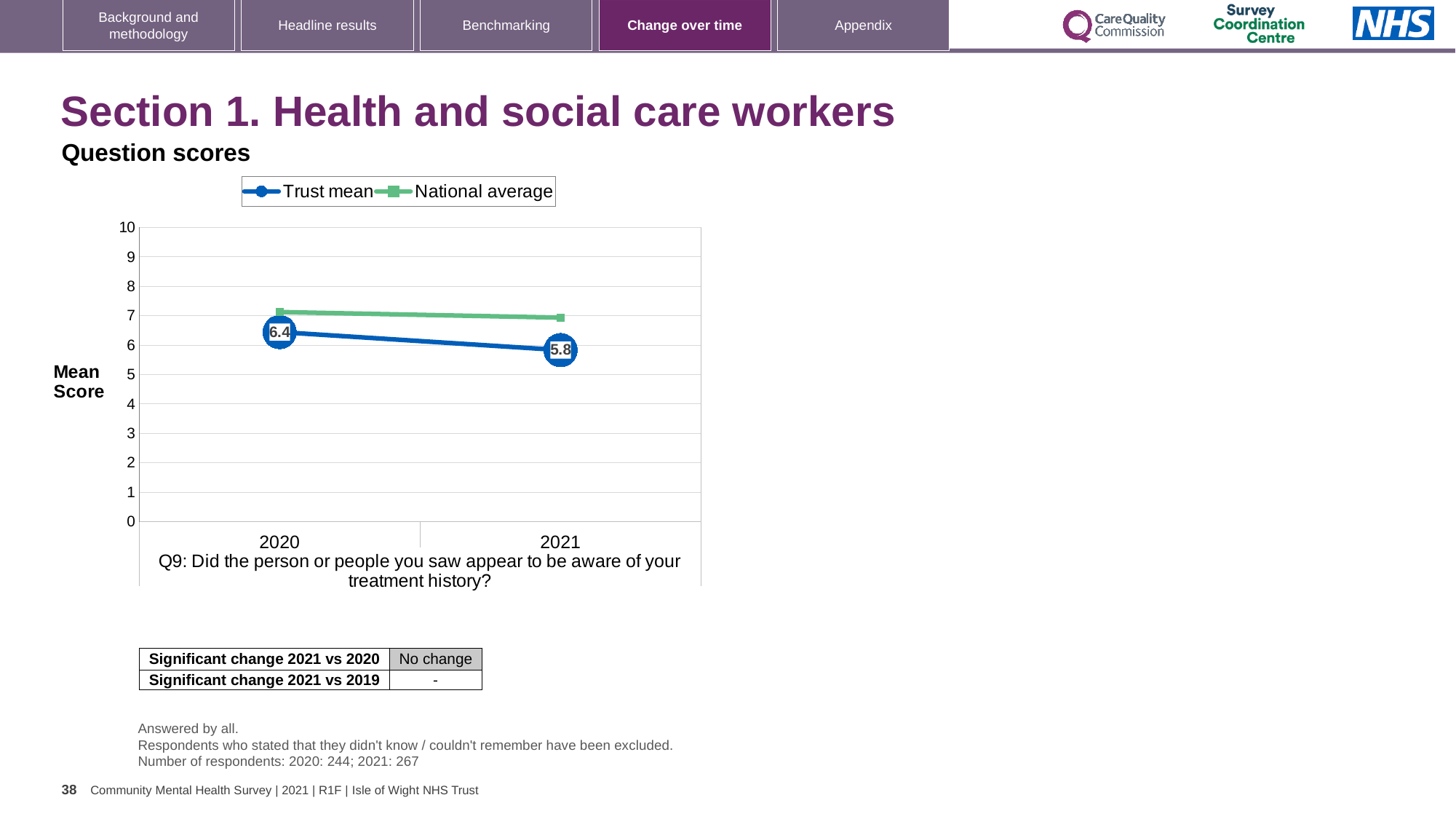
What is the label on the y axis of the chart? Mean Score Does the Trust mean rise or fall from 2020 to 2021? fall Is the National average for 2021 greater or less than 8? less In 2021, which is higher: the Trust mean or the National average? National average What is the Trust mean score for 2020? 6.4 How many series does the legend list? 2 Which year has the higher Trust mean score, 2020 or 2021? 2020 What kind of chart is shown on the slide? line chart By how much did the Trust mean score change from 2020 to 2021? 0.6 What is the Trust mean score for 2021? 5.8 Is the National average for 2020 greater or less than 6? greater How many years are plotted on the x axis? 2